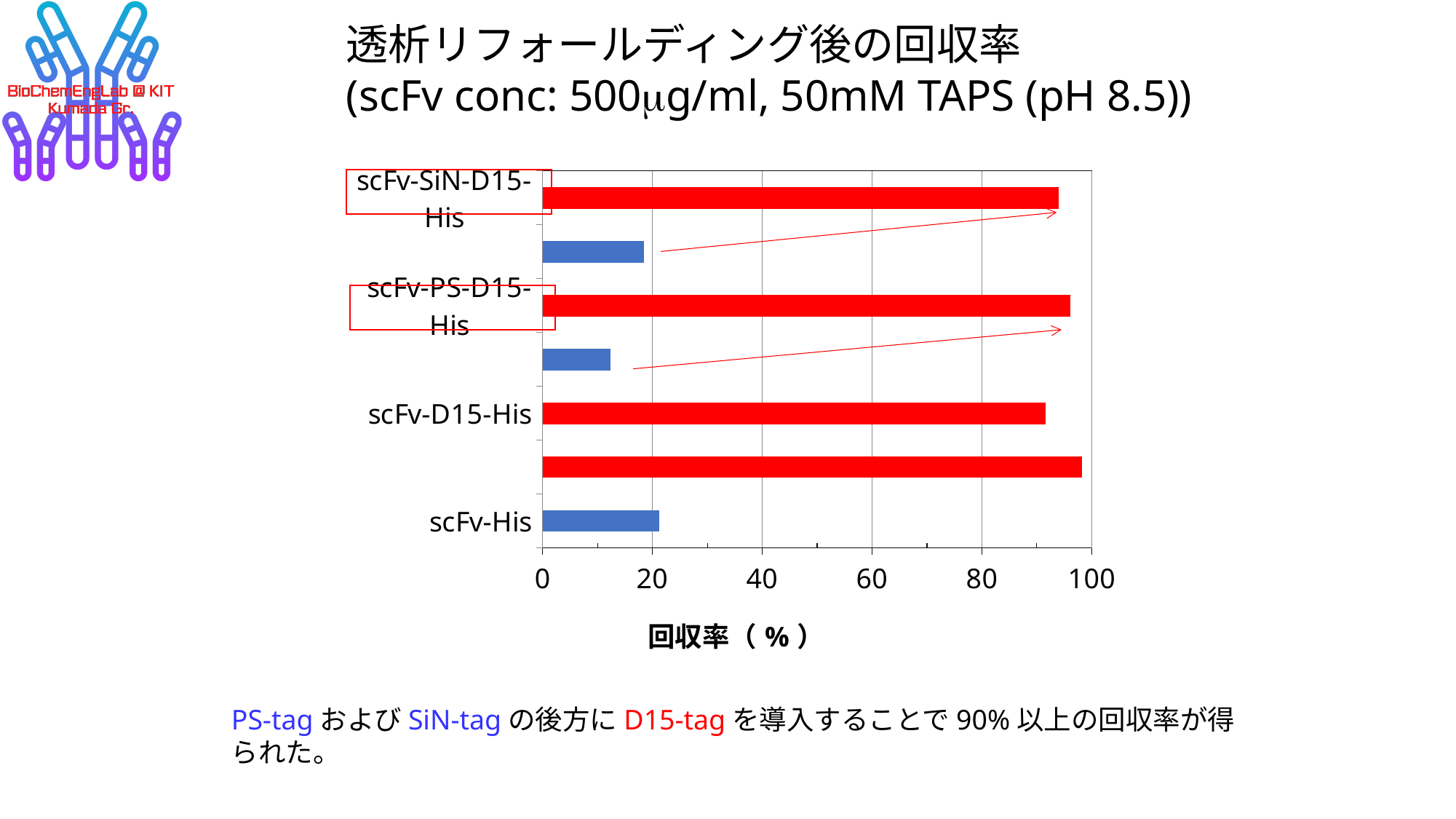
Is the value of the red bar next to the scFv-D15-His label greater or less than 80? greater Is the value of the topmost red bar greater or less than 80? greater How many red bars are there in the chart? 4 How many bars are plotted in the chart? 7 How many blue bars are there in the chart? 3 What kind of chart is shown on the slide? bar chart In the topmost pair of bars, is the red bar or the blue bar longer? red Is the value of the blue bar next to the scFv-PS-D15-His label greater or less than 20? less Which colour is the shortest bar in the chart? blue What is the label of the horizontal axis of the chart? 回収率（%）